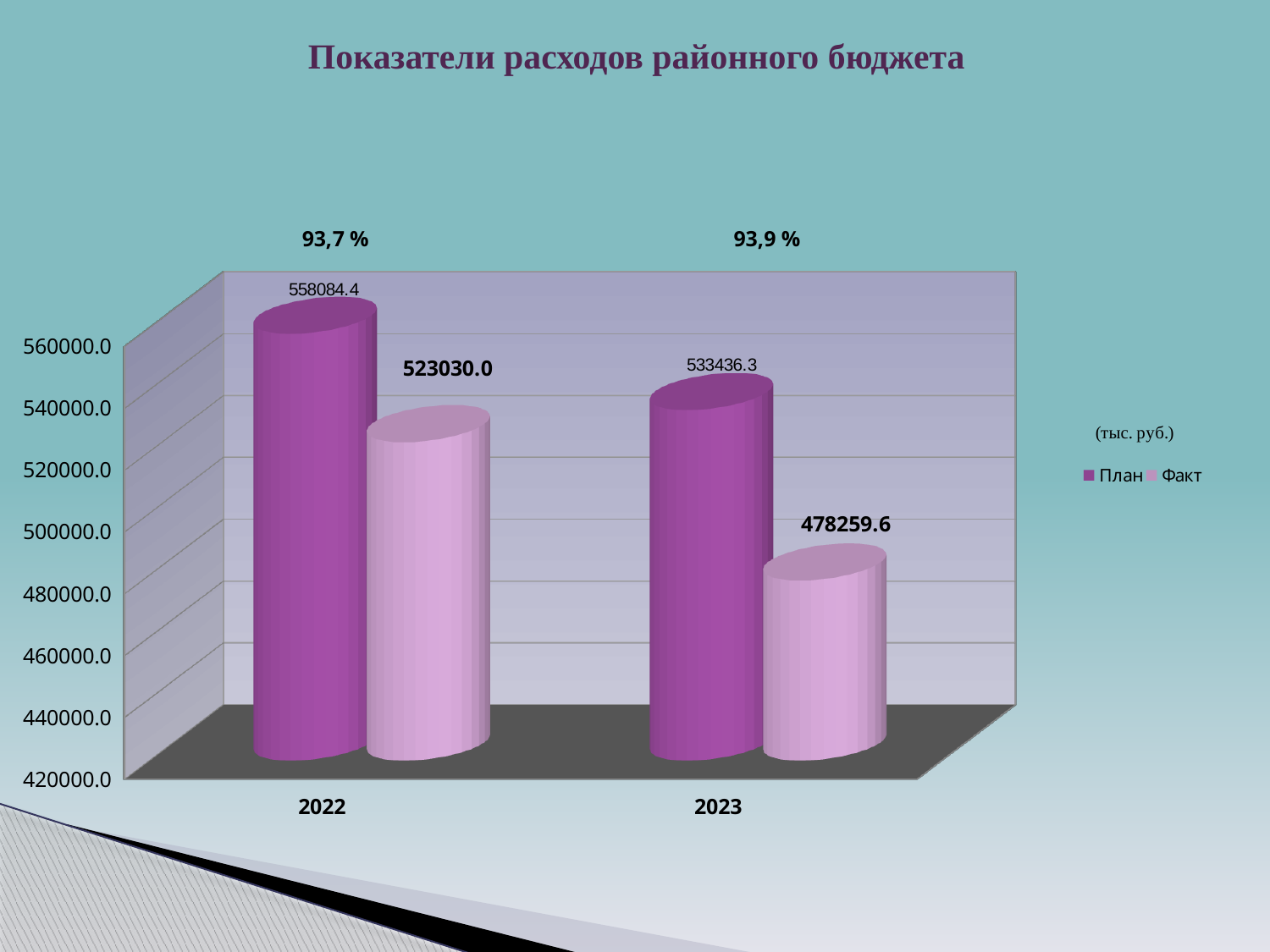
What is the План value for 2022? 558084.4 What percentage is shown above the 2023 bars? 93,9 % What is the difference between План and Факт for 2023? 55176.7 What type of chart is shown on the slide? bar chart How many series does the legend list? 2 What is the Факт value for 2023? 478259.6 Which bar is the lowest on the chart? Факт for 2023 What is the difference between План and Факт for 2022? 35054.4 What is the Факт value for 2022? 523030.0 Is the План value for 2023 larger or smaller than the План value for 2022? smaller What is the План value for 2023? 533436.3 Which year has the higher Факт value? 2022